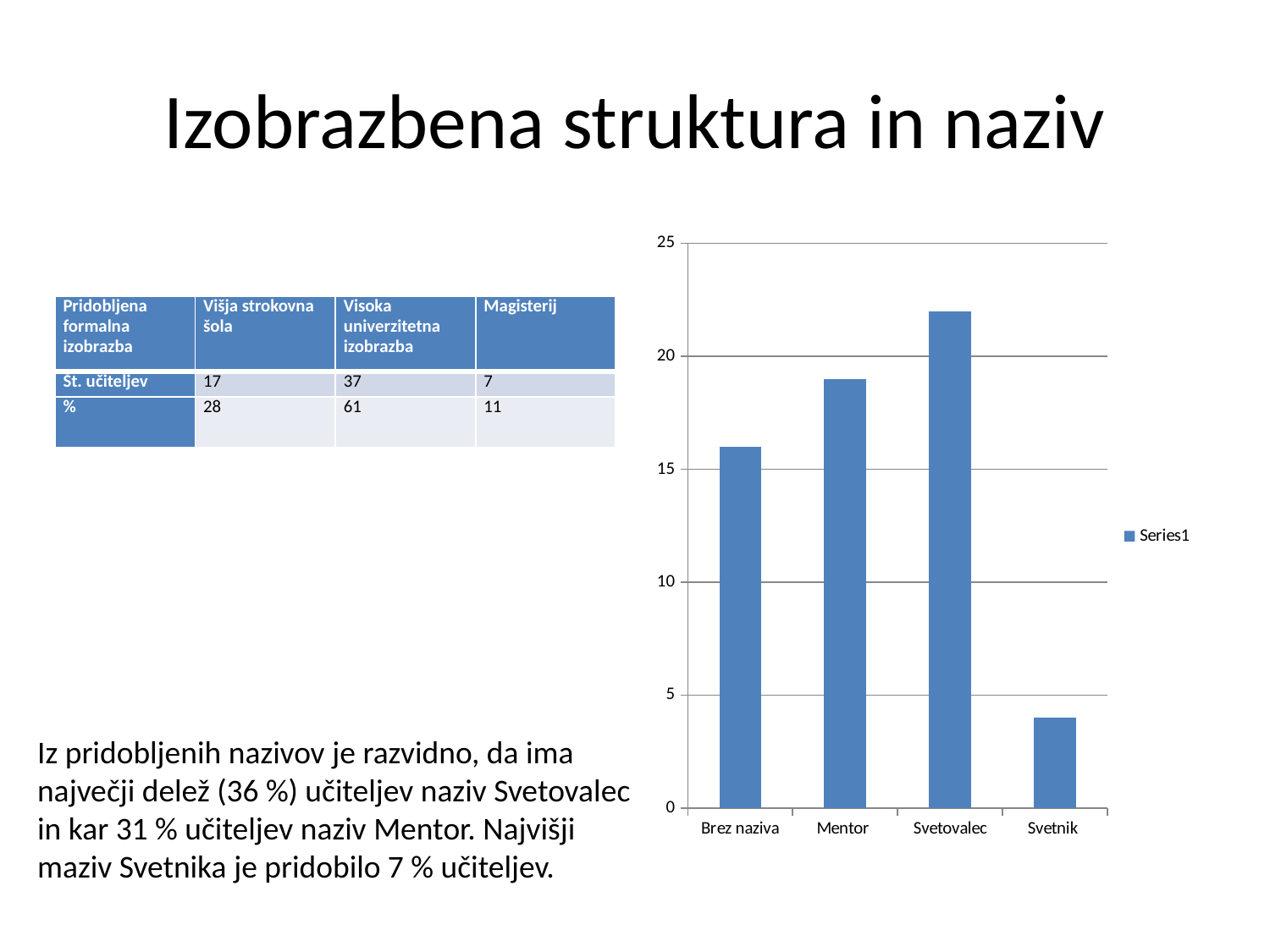
Which category has the highest bar in the chart? Svetovalec Is the value for Brez naziva greater or less than 15? greater Is the value for Svetovalec greater or less than 20? greater Is the value for Svetnik greater or less than 5? less How many categories are shown on the x axis of the chart? 4 Which is larger, the value for Mentor or the value for Brez naziva? Mentor What is the name of the series shown in the chart legend? Series1 Which category has the lowest bar in the chart? Svetnik How many series does the chart legend list? 1 Which is larger, the value for Svetnik or the value for Svetovalec? Svetovalec What kind of chart is shown on the slide? bar chart